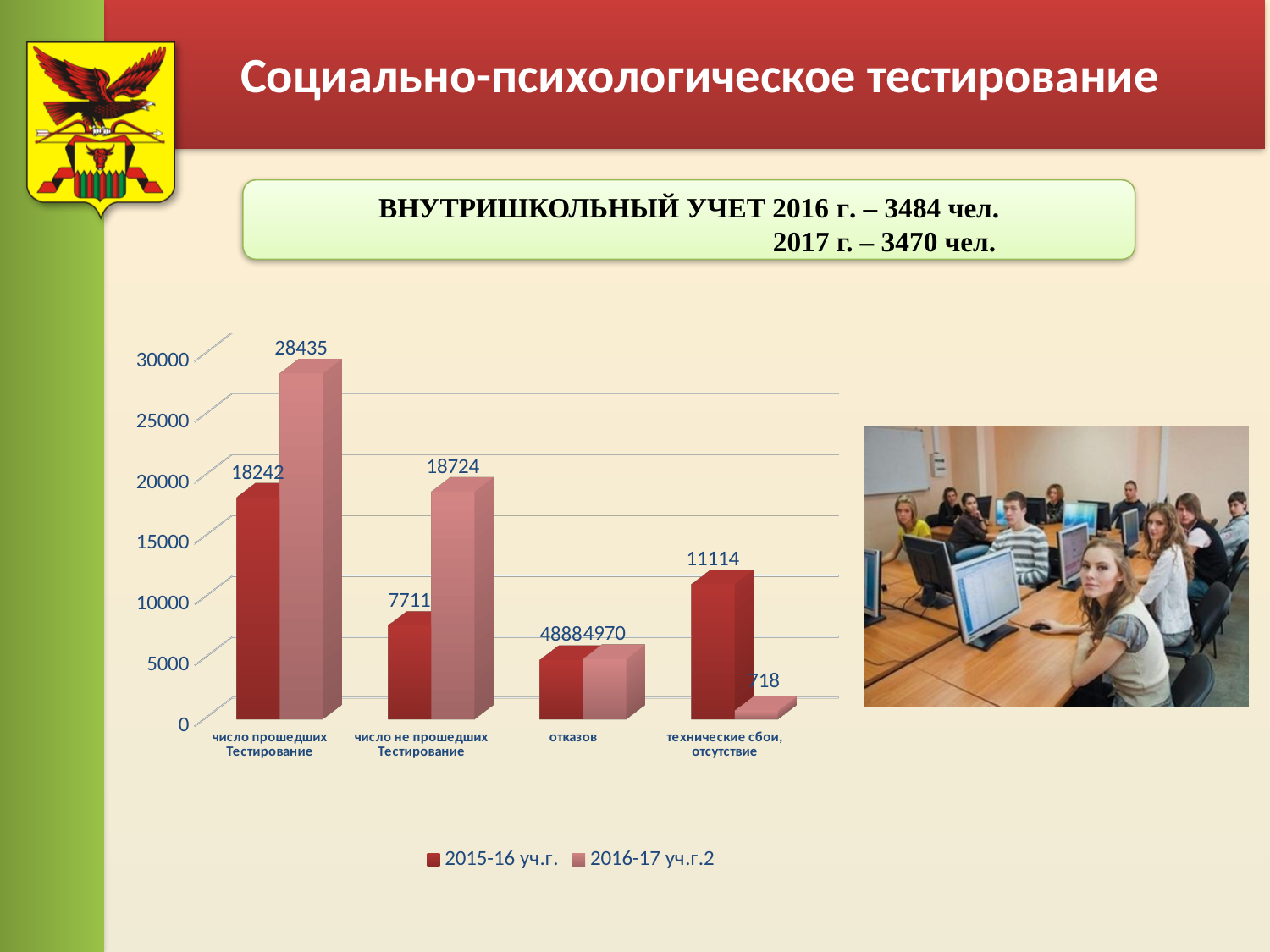
Is the 2015-16 уч.г. value for "технические сбои, отсутствие" greater or less than 10000? greater What type of chart is shown on the slide? bar chart For "технические сбои, отсутствие", which series has the larger value: 2015-16 уч.г. or 2016-17 уч.г.2? 2015-16 уч.г. What is the difference between the 2016-17 уч.г.2 and 2015-16 уч.г. values for "число не прошедших Тестирование"? 11013 Which category has the highest value in the 2016-17 уч.г.2 series? число прошедших Тестирование What is the value for "число прошедших Тестирование" in the 2016-17 уч.г.2 series? 28435 How many categories are shown on the x axis of the chart? 4 How many series does the chart legend list? 2 Which category has the lowest value in the 2016-17 уч.г.2 series? технические сбои, отсутствие What is the value for "число не прошедших Тестирование" in the 2015-16 уч.г. series? 7711 What is the value for "технические сбои, отсутствие" in the 2016-17 уч.г.2 series? 718 What is the value for "число прошедших Тестирование" in the 2015-16 уч.г. series? 18242